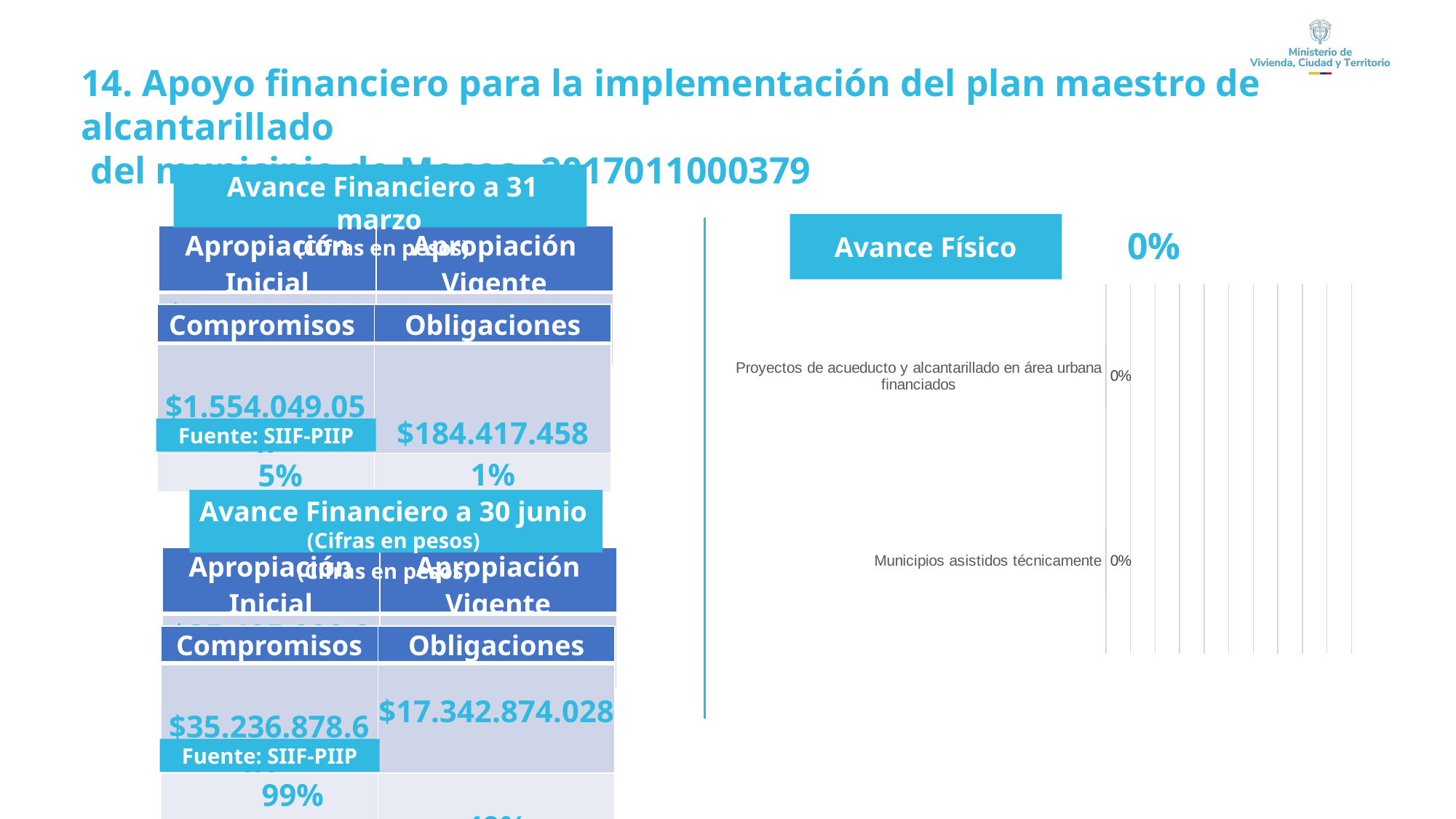
What kind of chart is the Avance Físico chart? bar chart What overall percentage is displayed next to the Avance Físico chart title? 0% In the Avance Físico chart, what is the value for 'Municipios asistidos técnicamente'? 0% In the Avance Físico chart, what is the difference between the value for 'Municipios asistidos técnicamente' and the value for 'Proyectos de acueducto y alcantarillado en área urbana financiados'? 0% In the Avance Físico chart, what is the value for 'Proyectos de acueducto y alcantarillado en área urbana financiados'? 0% What is the title of the chart on the right side of the slide? Avance Físico How many categories does the Avance Físico chart show? 2